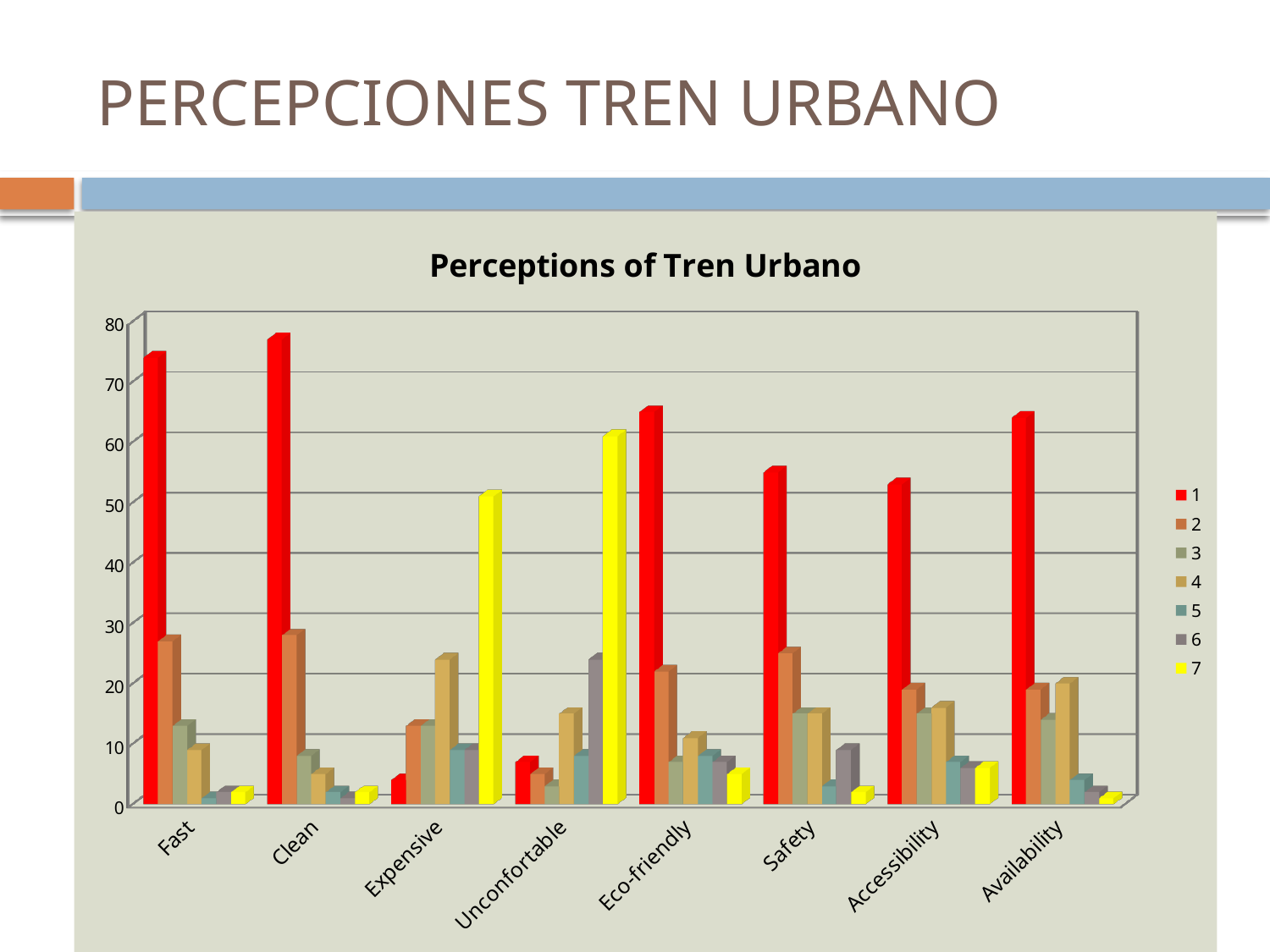
Which is larger: the value of series 7 for Unconfortable or the value of series 7 for Expensive? Unconfortable What is the title of the chart? Perceptions of Tren Urbano Is the value of series 1 for Eco-friendly greater or less than 60? greater How many series does the chart's legend list? 7 Is the value of series 1 for Fast greater or less than 70? greater Is the value of series 1 for Expensive greater or less than 10? less What kind of chart is shown on the slide? bar chart How many categories are shown on the x axis of the chart? 8 Which category has the lowest value for series 1? Expensive Which series has the highest value for the Expensive category? 7